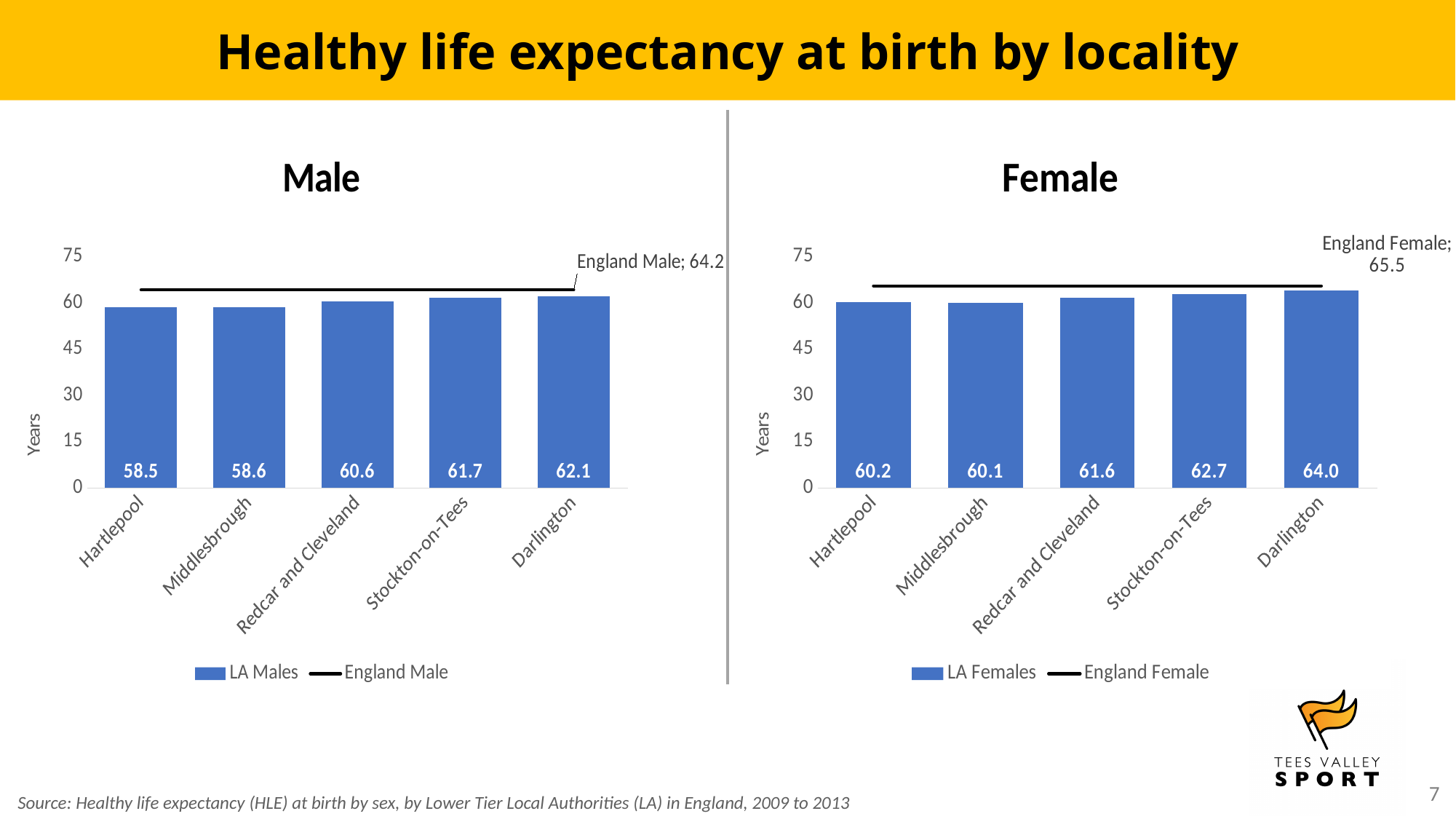
How many series does the legend of the Female chart list? 2 How many localities are shown in the Male chart? 5 In the Female chart, do the values rise or fall from Redcar and Cleveland to Darlington? Rise In the Female chart, which is larger: Redcar and Cleveland or Middlesbrough? Redcar and Cleveland In the Male chart, what is the England Male value shown? 64.2 In the Female chart, what is the difference between Darlington and Hartlepool? 3.8 In the Male chart, what is the healthy life expectancy value for Hartlepool? 58.5 In the Male chart, what is the difference between the England Male value and Darlington? 2.1 In the Female chart, what is the healthy life expectancy value for Stockton-on-Tees? 62.7 In the Female chart, which locality has the highest value? Darlington What kind of chart is the Male chart? Bar chart In the Male chart, which locality has the lowest value? Hartlepool